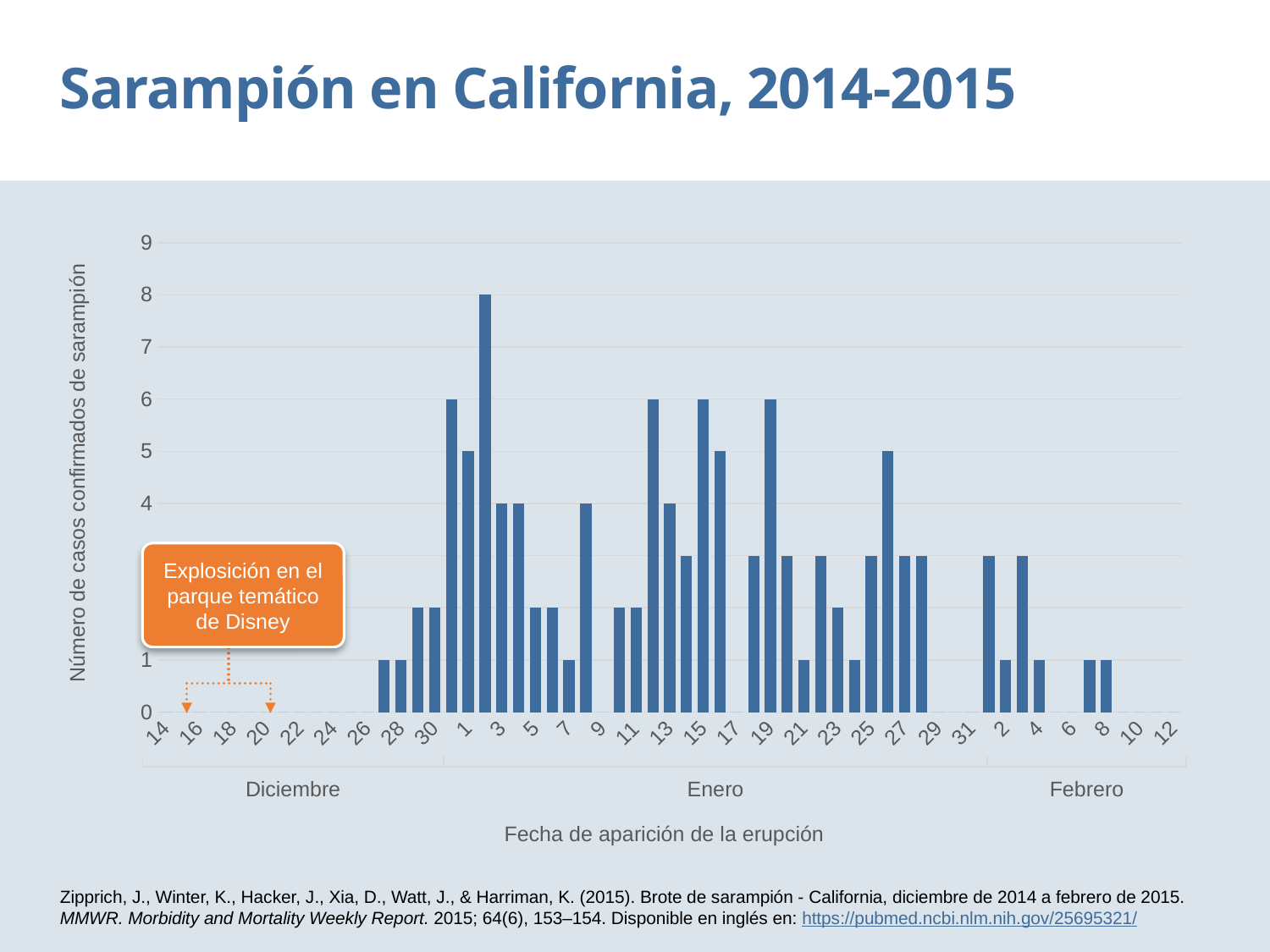
What is the highest value shown on the y axis? 9 How many confirmed cases are shown for 1 de enero? 5 Is the value for 13 de enero greater or less than 3? greater What is the highest number of confirmed measles cases recorded on a single day in the chart? 8 How many bars in the chart reach a value of 5? 3 Is the value for 8 de febrero greater or less than 2? less How many bars in the chart reach a value of 6? 4 Which is larger, the value for 15 de enero or the value for 21 de enero? 15 de enero What is the title of the slide's chart? Sarampión en California, 2014-2015 What kind of chart is shown on the slide? bar chart How many confirmed cases are shown for 15 de enero? 6 How many confirmed cases are shown for 19 de enero? 6